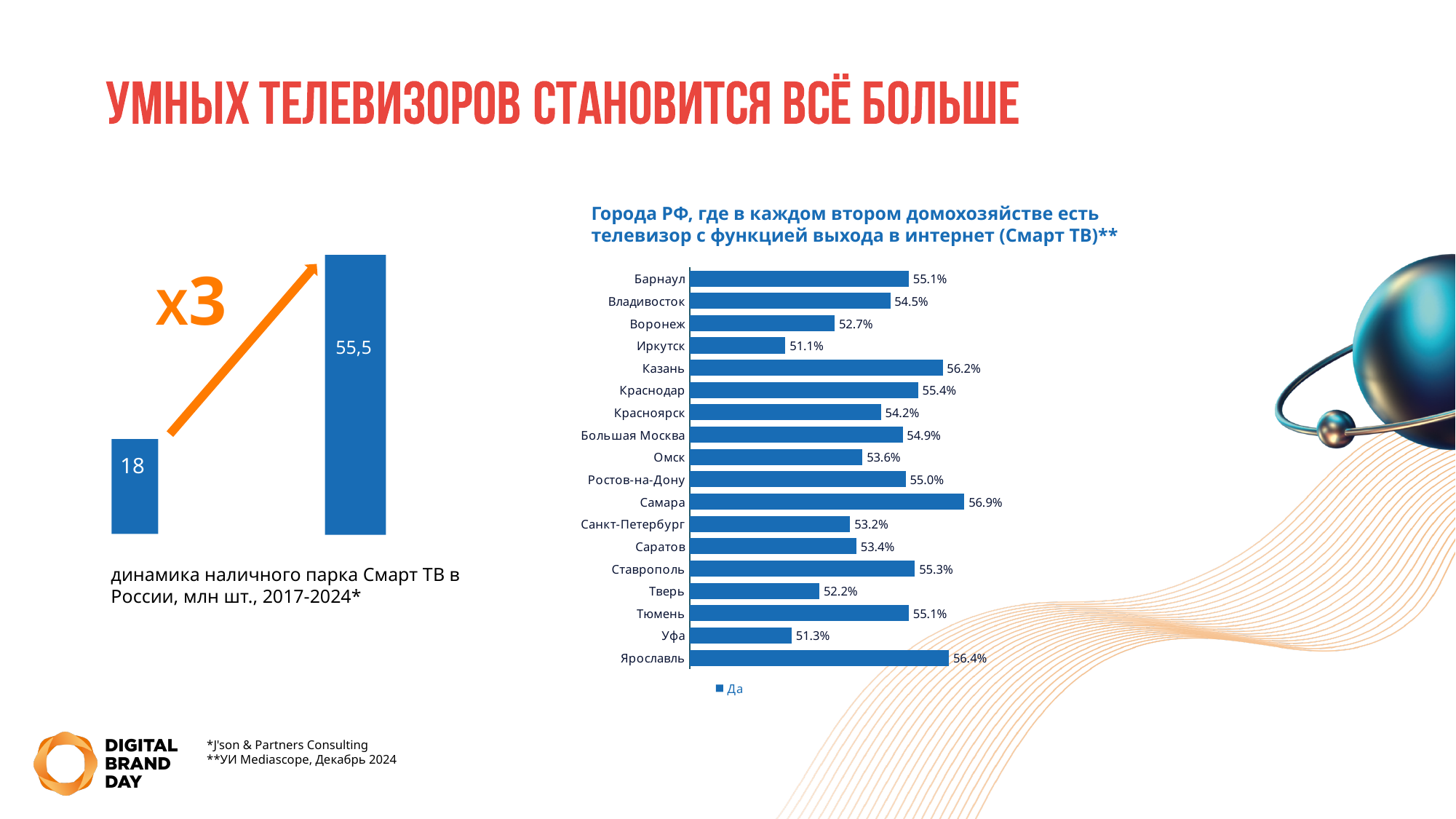
In the right chart (Города РФ...), what is the difference between the values for Самара and Иркутск? 5.8% In the right chart (Города РФ...), how many cities are shown? 18 In the right chart (Города РФ...), which is larger, the value for Ярославль or the value for Санкт-Петербург? Ярославль In the right chart (Города РФ...), which city has the lowest value? Иркутск What kind of chart is the left chart (динамика наличного парка Смарт ТВ в России)? Bar chart In the right chart (Города РФ, где в каждом втором домохозяйстве есть телевизор с функцией выхода в интернет), what is the value for Казань? 56.2% In the right chart (Города РФ...), what is the value for Большая Москва? 54.9% In the right chart (Города РФ...), how many series does the legend list? 1 In the right chart (Города РФ...), which city has the highest value? Самара In the right chart (Города РФ...), what is the legend entry? Да In the left chart (динамика наличного парка Смарт ТВ в России), what is the value of the taller bar? 55,5 In the left chart (динамика наличного парка Смарт ТВ в России), what is the difference between the two bars? 37,5